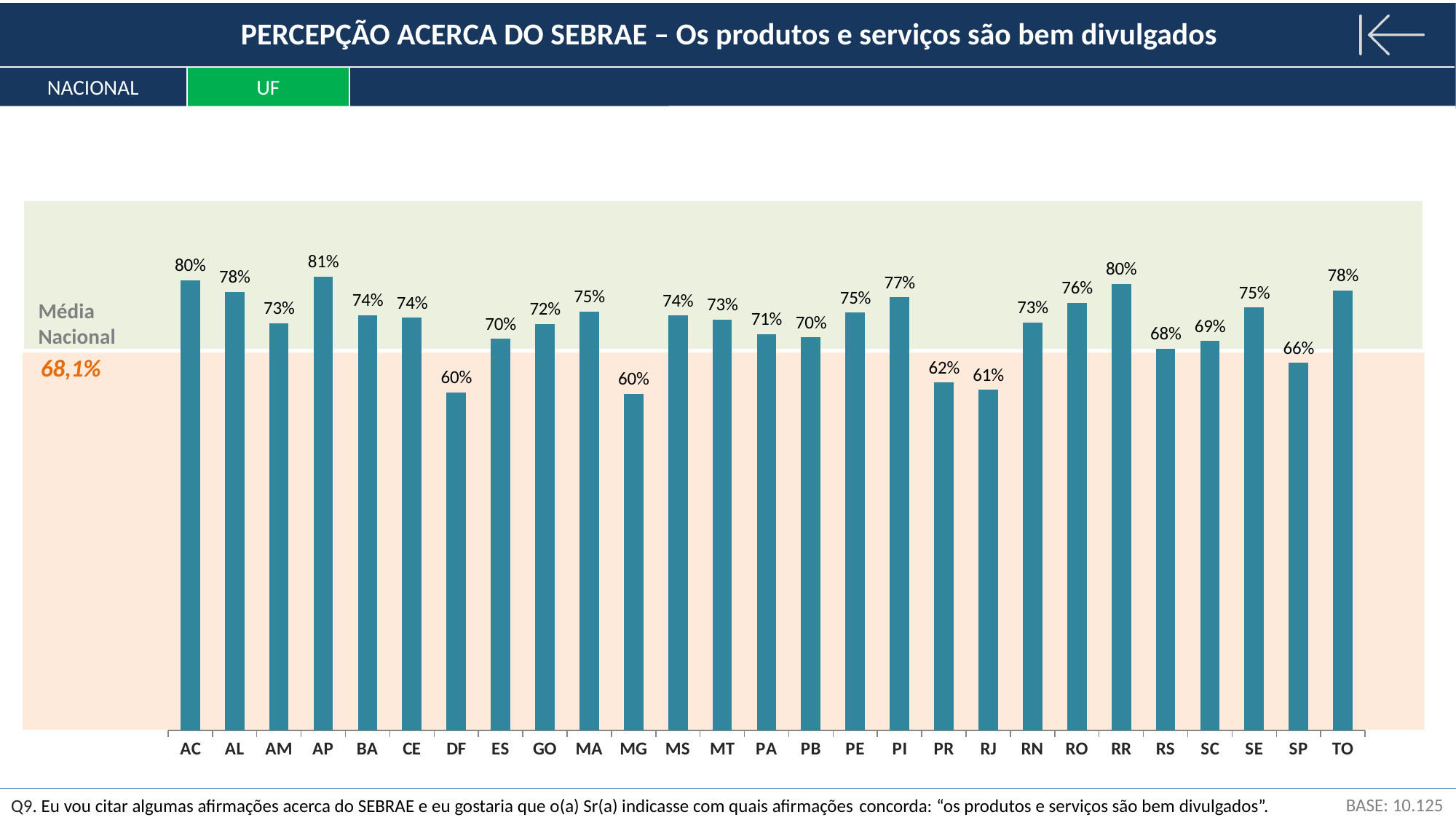
What is the value for SP? 66% What is the value for PI? 77% Which state has the highest value? AP What is the value for AP? 81% What is the value of the Média Nacional shown on the chart? 68,1% Which is larger, the value for RO or the value for SC? RO What is the difference between the values for TO and RS? 10% What kind of chart is shown on the slide? Bar chart How many states are shown on the x axis? 27 What is the value for DF? 60% Which is larger, the value for PR or the value for MA? MA What is the difference between the values for AC and RJ? 19%